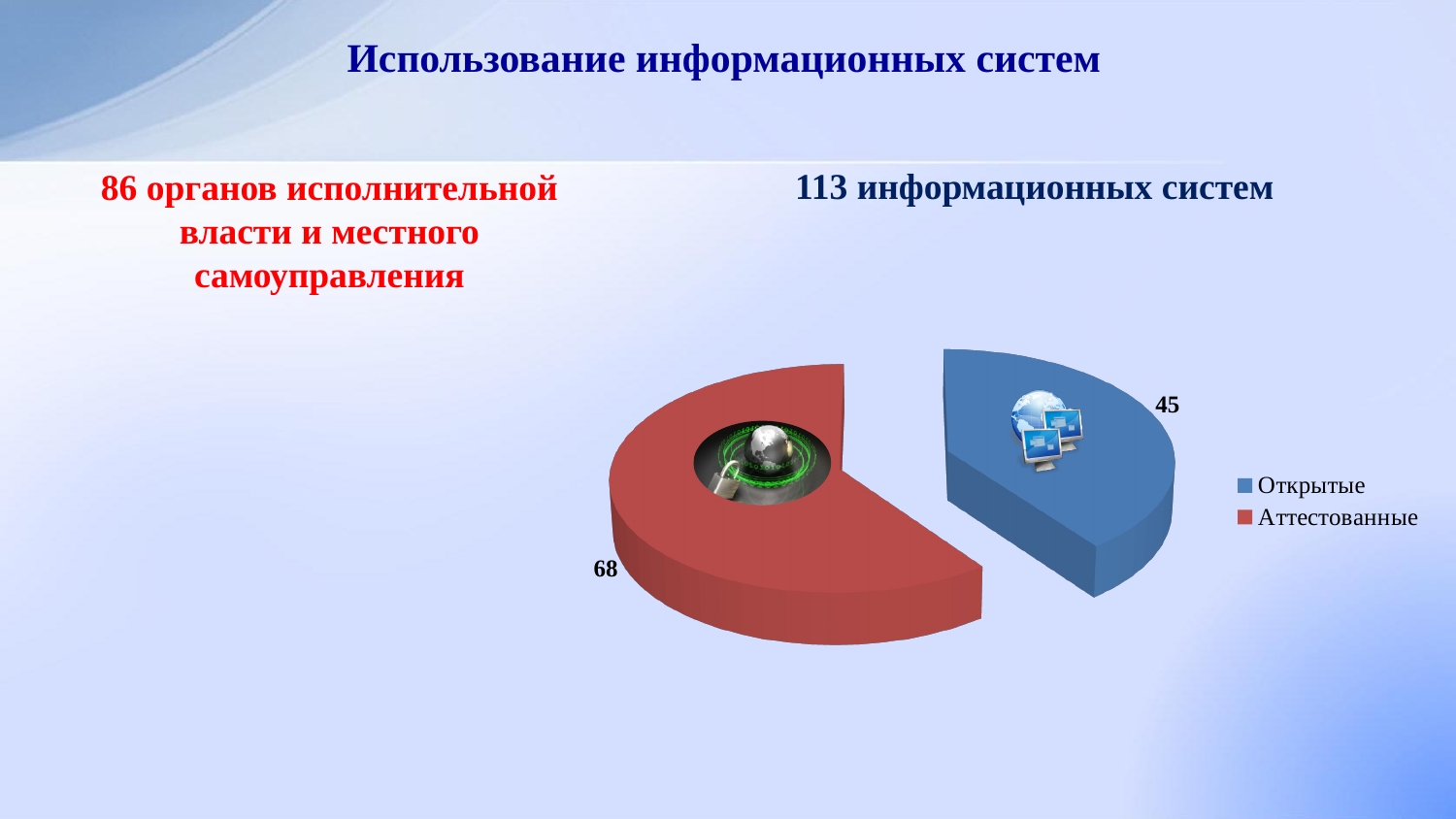
How many slices does the pie chart have? 2 Which category has the smallest slice in the pie chart? Открытые What colour is the Открытые slice in the pie chart? Blue What is the total of the two slices in the pie chart? 113 Which category has the largest slice in the pie chart? Аттестованные What is the value for Аттестованные in the pie chart? 68 What kind of chart is shown on the slide? Pie chart How many entries does the legend list? 2 What colour is the Аттестованные slice in the pie chart? Red Which is larger, the value for Открытые or the value for Аттестованные? Аттестованные What is the value for Открытые in the pie chart? 45 What is the difference between the values for Аттестованные and Открытые? 23